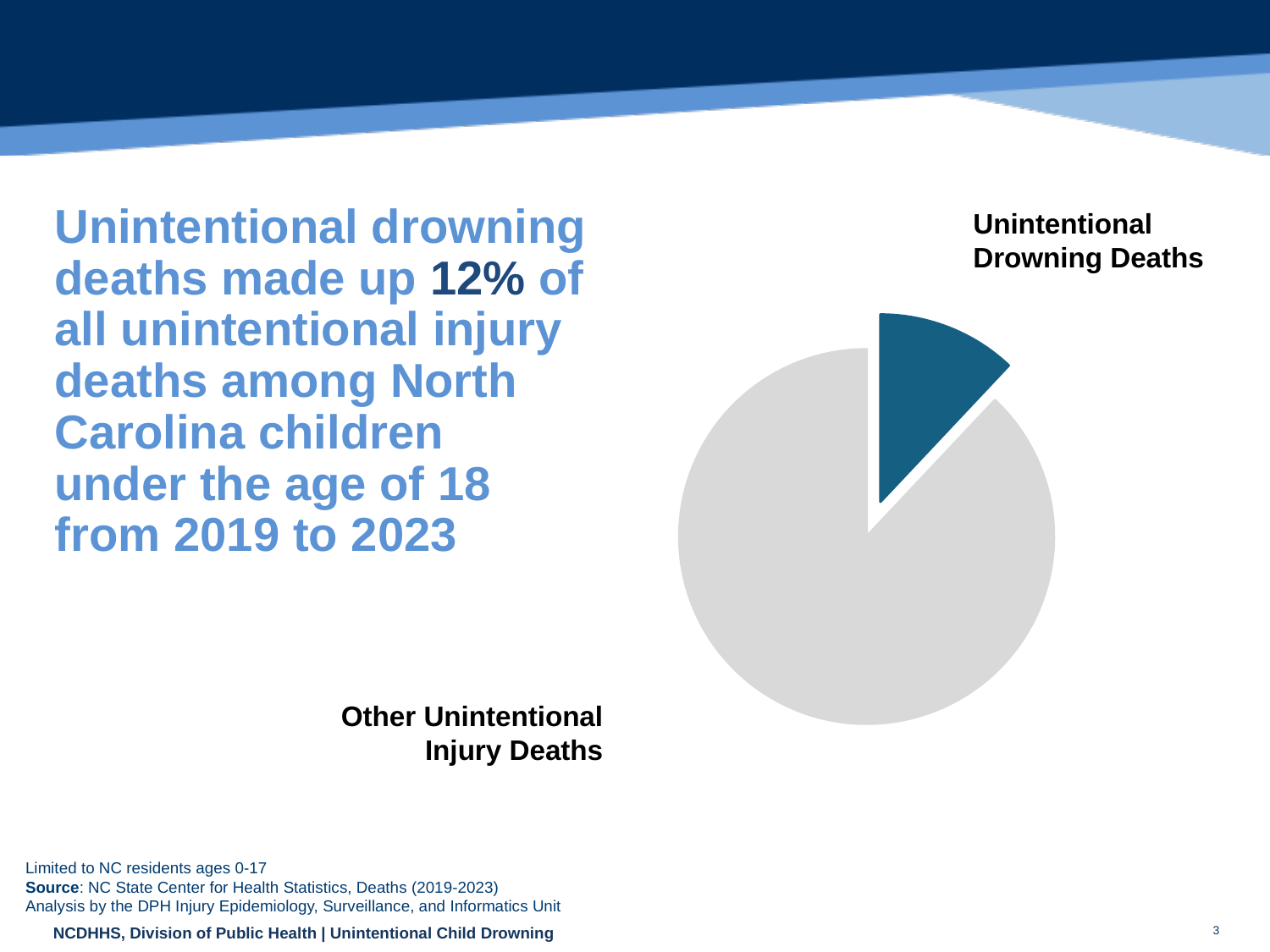
Is the Other Unintentional Injury Deaths slice greater or less than 50% of the pie? greater Which is larger in the pie chart: Unintentional Drowning Deaths or Other Unintentional Injury Deaths? Other Unintentional Injury Deaths What kind of chart is shown on the slide? pie chart How many slices does the pie chart have? 2 What share of the pie does the Other Unintentional Injury Deaths slice represent? 88% What share of the pie does the Unintentional Drowning Deaths slice represent? 12% What colour is the Unintentional Drowning Deaths slice in the pie chart? dark teal blue What is the label of the grey slice in the pie chart? Other Unintentional Injury Deaths Is the Unintentional Drowning Deaths slice greater or less than 50% of the pie? less Which slice of the pie chart is the largest? Other Unintentional Injury Deaths Which slice of the pie chart is the smallest? Unintentional Drowning Deaths